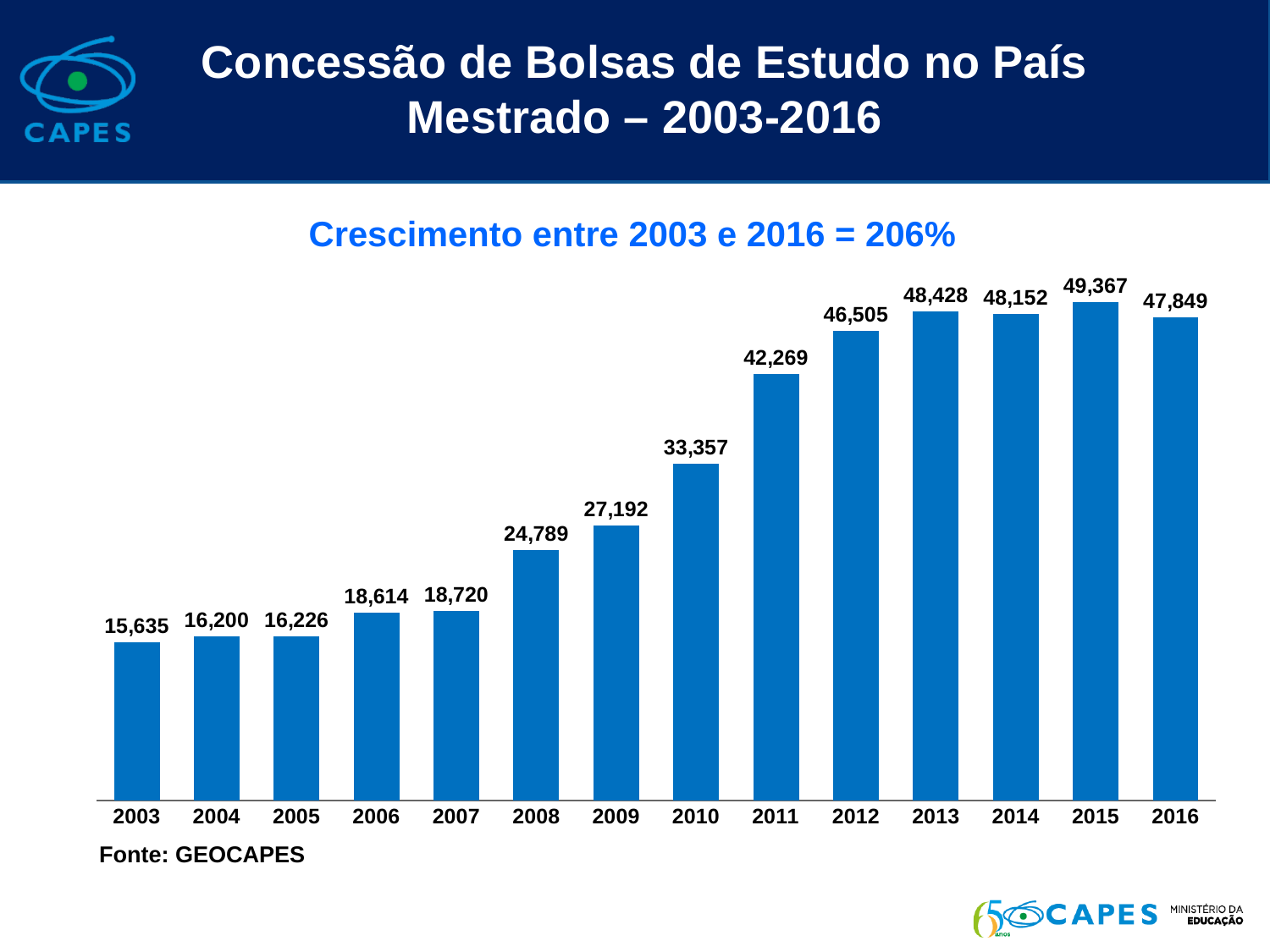
What is the difference between the values for 2015 and 2014? 1,215 What kind of chart is this? bar chart Which year has the lowest value? 2003 Which year has the highest value? 2015 Which is larger, the value for 2013 or the value for 2014? 2013 Do the values generally rise or fall from 2003 to 2013? rise What is the value for 2016? 47,849 What is the difference between the values for 2016 and 2003? 32,214 What growth percentage between 2003 and 2016 is stated above the chart? 206% What is the value for 2010? 33,357 How many years are shown on the x axis? 14 What is the value for 2003? 15,635